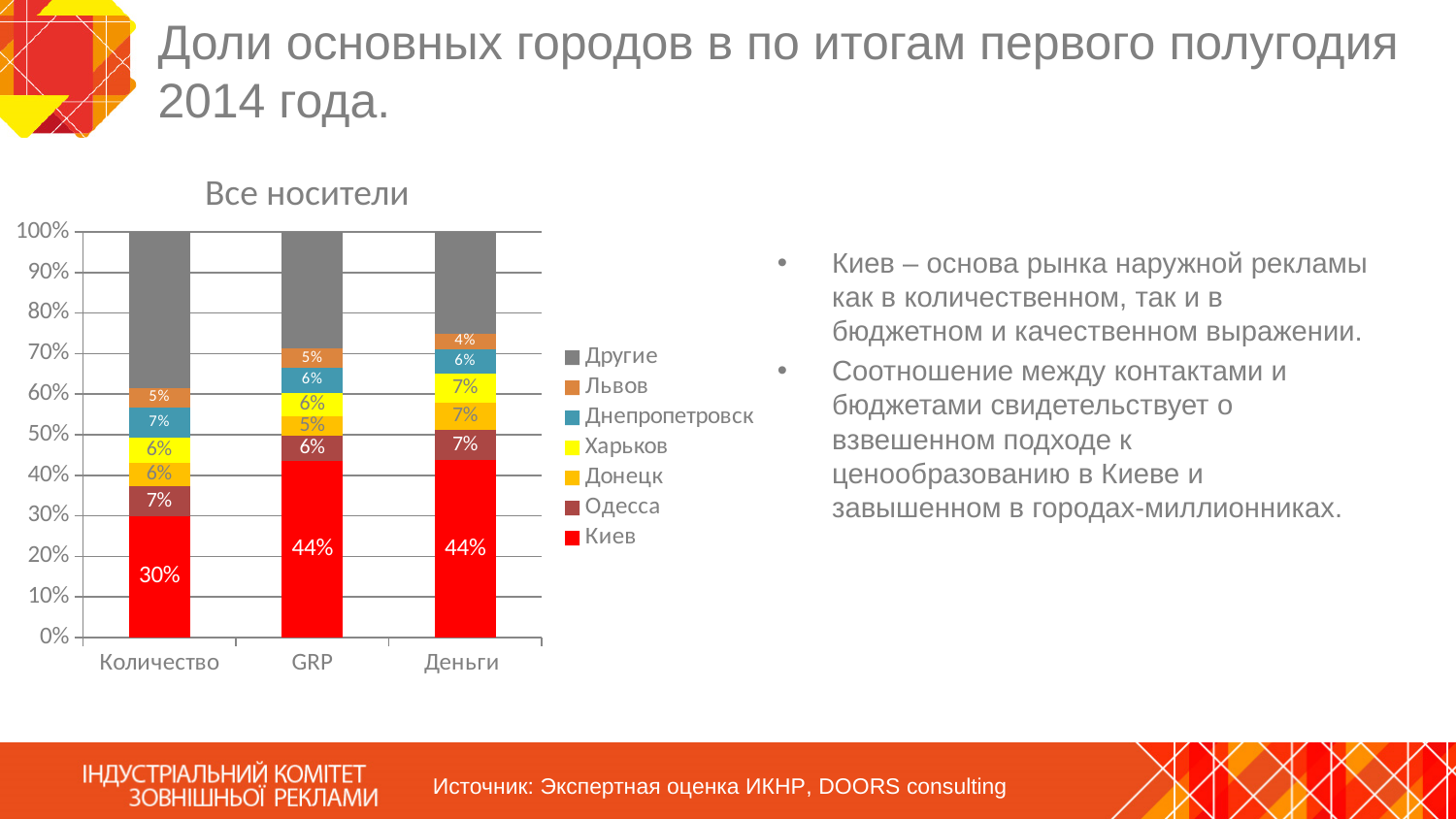
What is the value for Одесса in the Количество bar? 7% Is the value for Другие in the Количество bar greater or less than 30%? greater What is the value for Донецк in the GRP bar? 5% How many series does the legend list? 7 What is the value for Киев in the GRP bar? 44% What is the value for Львов in the Деньги bar? 4% What is the value for Киев in the Количество bar? 30% What is the difference between the Киев value in the Деньги bar and the Киев value in the Количество bar? 14% What is the title of the chart? Все носители Which is larger: the Днепропетровск value in the Количество bar or in the Деньги bar? Количество How many categories are shown on the x axis? 3 What kind of chart is shown on the slide? Stacked bar chart